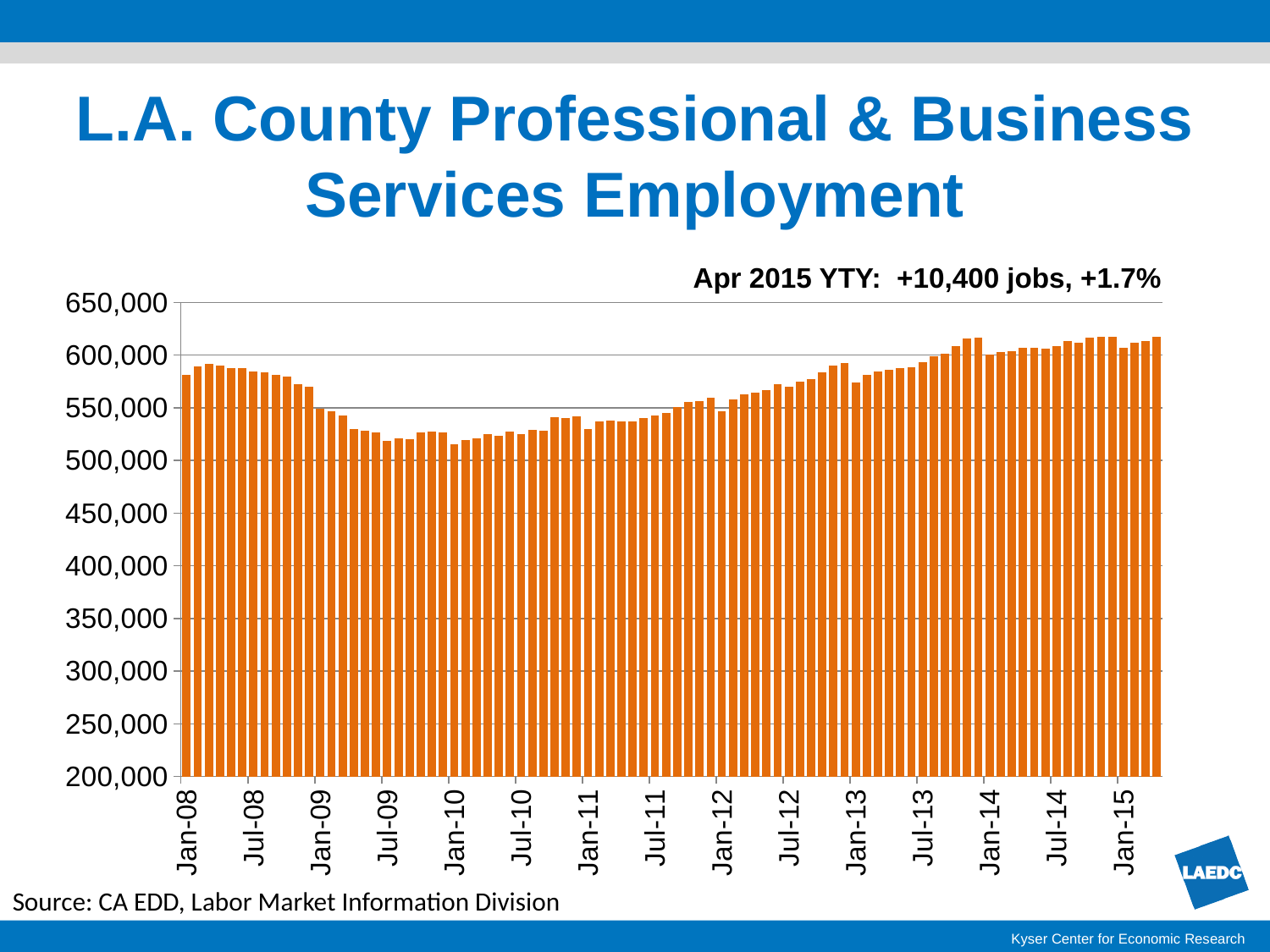
Is the value for Jan-10 greater or less than 550,000? less Which is larger, the value for Jan-08 or the value for Jan-10? Jan-08 Is the value for Jul-12 greater or less than 550,000? greater What kind of chart is shown on the slide? bar chart What is the title of the chart? L.A. County Professional & Business Services Employment Do the values rise or fall from Jan-10 to Jan-15? rise Is the value for Jan-08 greater or less than 550,000? greater Do the values rise or fall from Jan-08 to Jan-10? fall According to the annotation on the chart, what was the Apr 2015 year-to-year change in jobs? +10,400 jobs, +1.7%